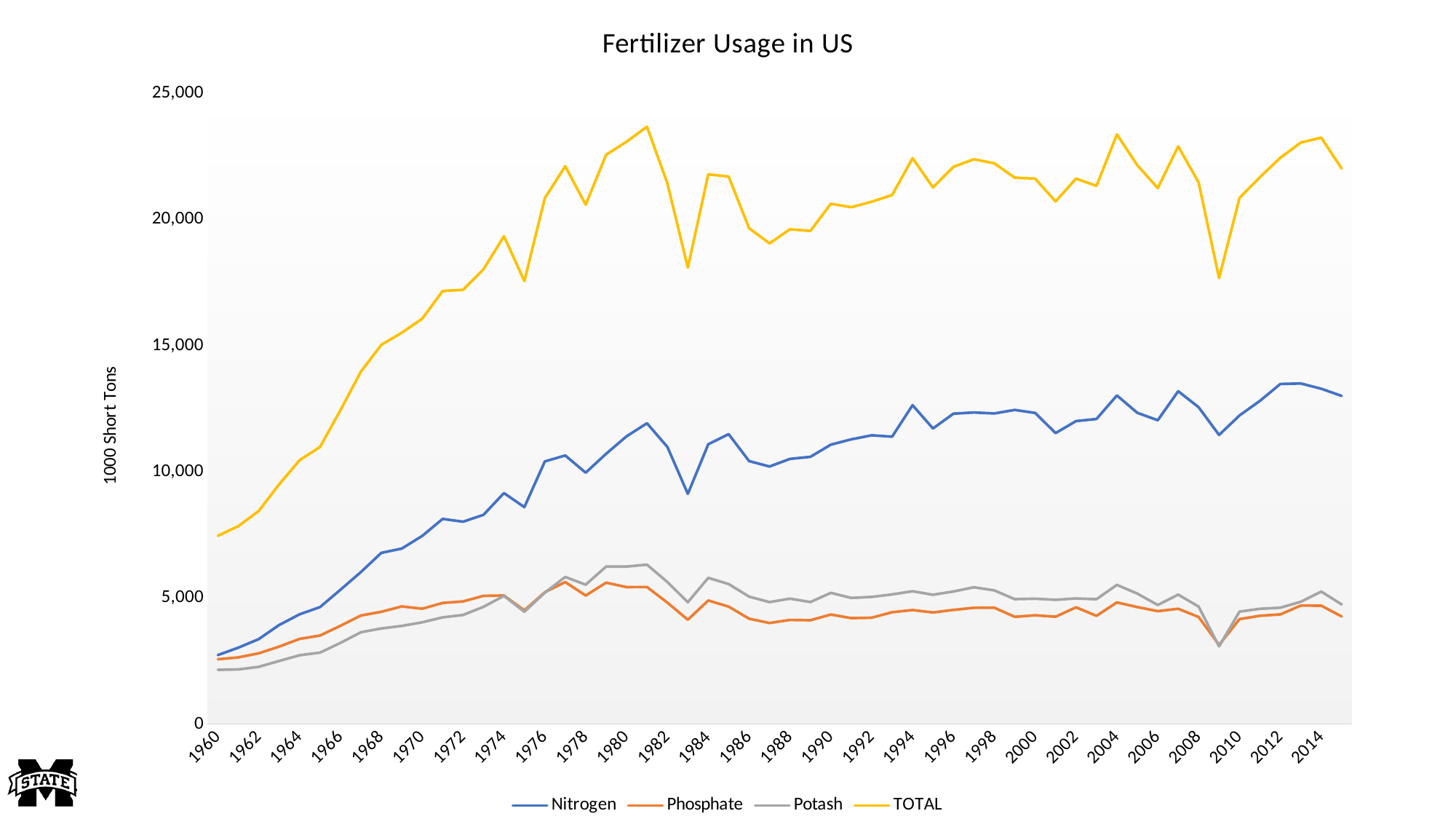
Is the value for Potash in 1980 greater or less than 5,000? greater What kind of chart is shown on the slide? line chart Is the value for Phosphate in 2015 greater or less than 5,000? less How many series does the legend list? 4 What is the title of the chart? Fertilizer Usage in US Is the value for TOTAL in 1981 greater or less than 20,000? greater Which series has the highest values across the whole chart? TOTAL In 1960, which is larger: Nitrogen or Potash? Nitrogen What is the label on the vertical axis? 1000 Short Tons Does the Nitrogen line rise or fall between 1960 and 1980? rise